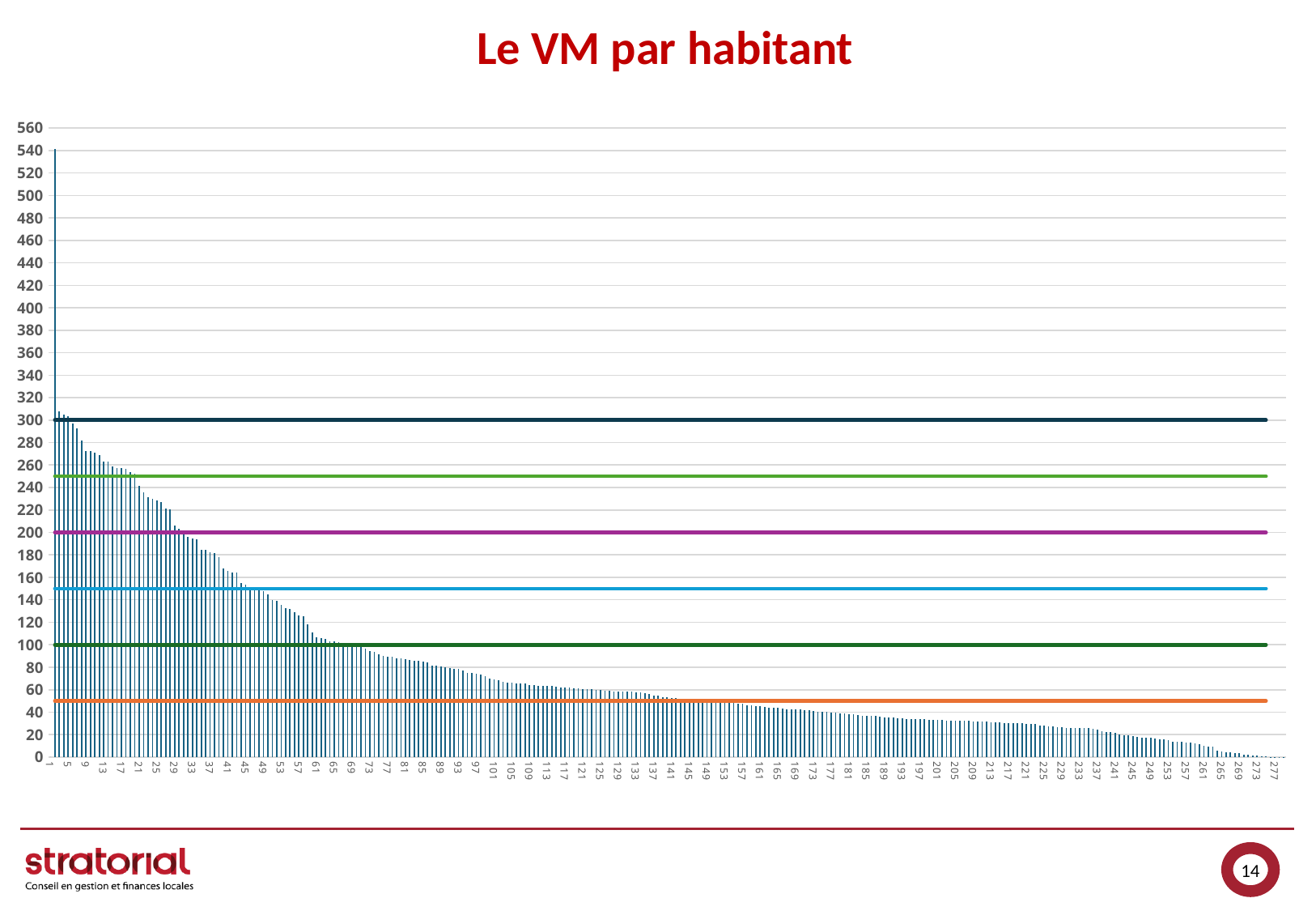
What kind of chart is shown on the slide? bar chart How many horizontal reference lines are drawn across the chart? 6 Is the value for category 21 greater or less than 200? greater Is the value for category 177 greater or less than 50? less Do the bar values rise or fall as you move from left to right along the x axis? fall Is the value for category 81 greater or less than 100? less Which is larger, the value for category 5 or the value for category 101? category 5 What is the title of the chart? Le VM par habitant